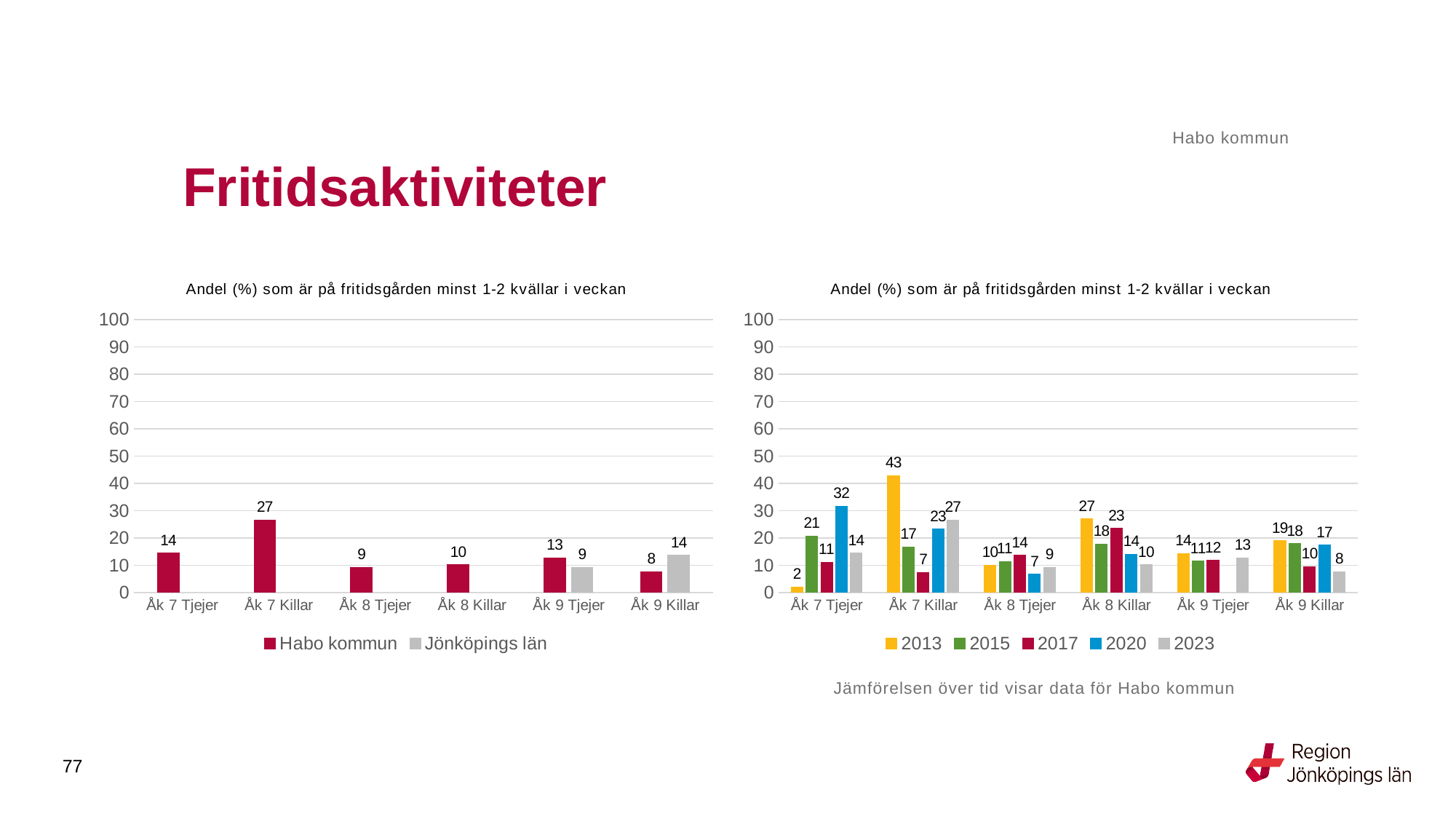
In the left chart, what is the value for Habo kommun for Åk 7 Killar? 27 What kind of chart is the left chart? Bar chart In the right chart, how many series does the legend list? 5 In the right chart, what is the value for 2013 for Åk 7 Killar? 43 In the left chart, which category has the highest value for Habo kommun? Åk 7 Killar In the left chart, which category has the lowest value for Habo kommun? Åk 9 Killar In the left chart, how many series does the legend list? 2 In the right chart, what is the value for 2020 for Åk 7 Tjejer? 32 In the right chart, which is larger for Åk 8 Killar: 2013 or 2023? 2013 How many categories are shown on the x axis of the right chart? 6 In the right chart, what is the difference between the 2013 and 2023 values for Åk 7 Tjejer? 12 In the left chart, what is the difference between Habo kommun and Jönköpings län for Åk 9 Killar? 6